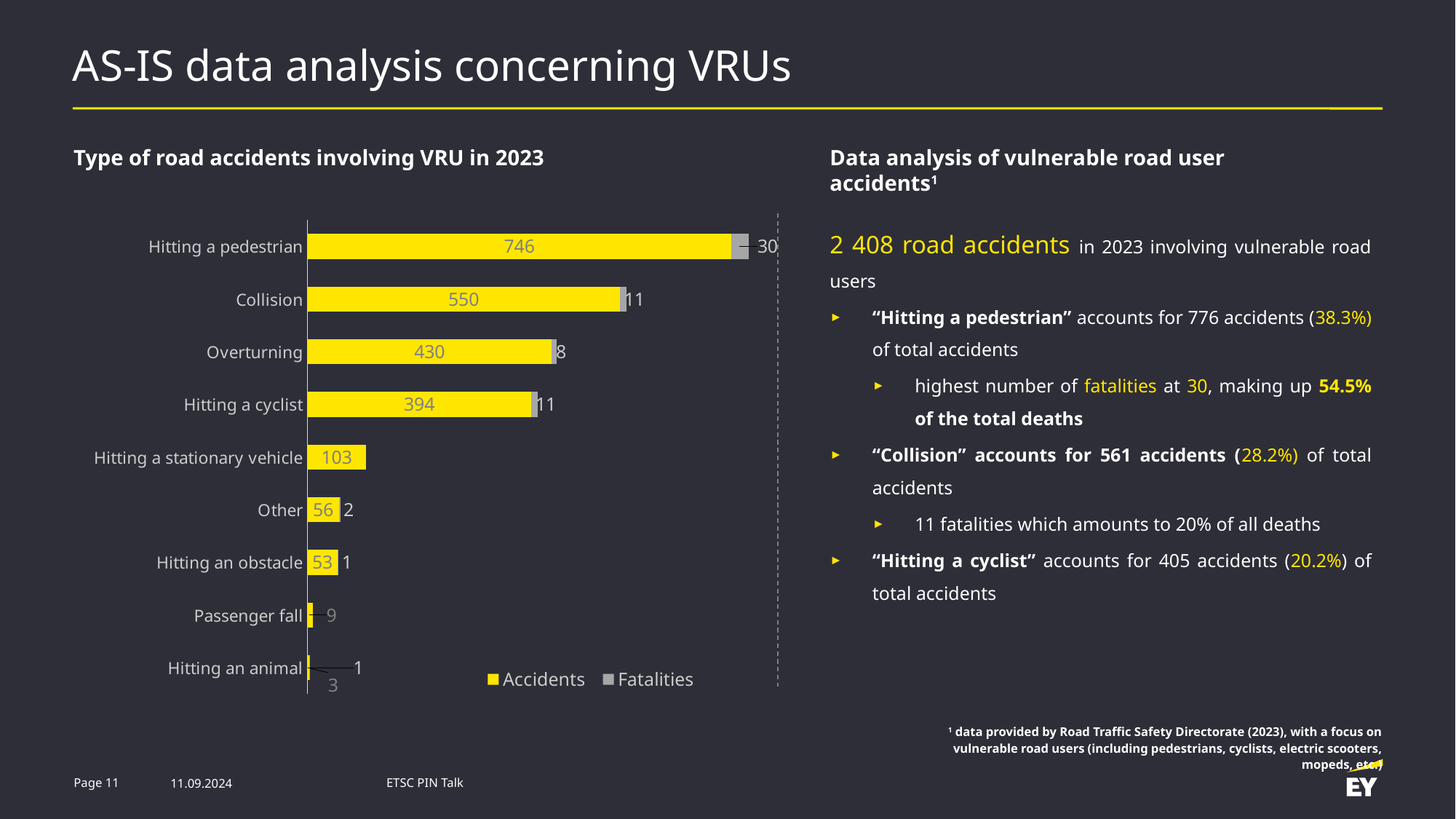
What is the number of accidents for 'Overturning'? 430 What is the number of accidents for 'Hitting an obstacle'? 53 What is the number of accidents for 'Hitting a pedestrian'? 746 How many accident categories are shown on the chart? 9 What is the number of fatalities for 'Hitting a cyclist'? 11 How many series does the legend of the chart list? 2 What is the difference in accidents between 'Collision' and 'Hitting a cyclist'? 156 Which category has the highest number of accidents? Hitting a pedestrian What type of chart is 'Type of road accidents involving VRU in 2023'? bar chart Which has more accidents, 'Hitting a stationary vehicle' or 'Other'? Hitting a stationary vehicle Which colour represents the 'Accidents' series in the chart? yellow What is the number of fatalities for 'Hitting a pedestrian'? 30